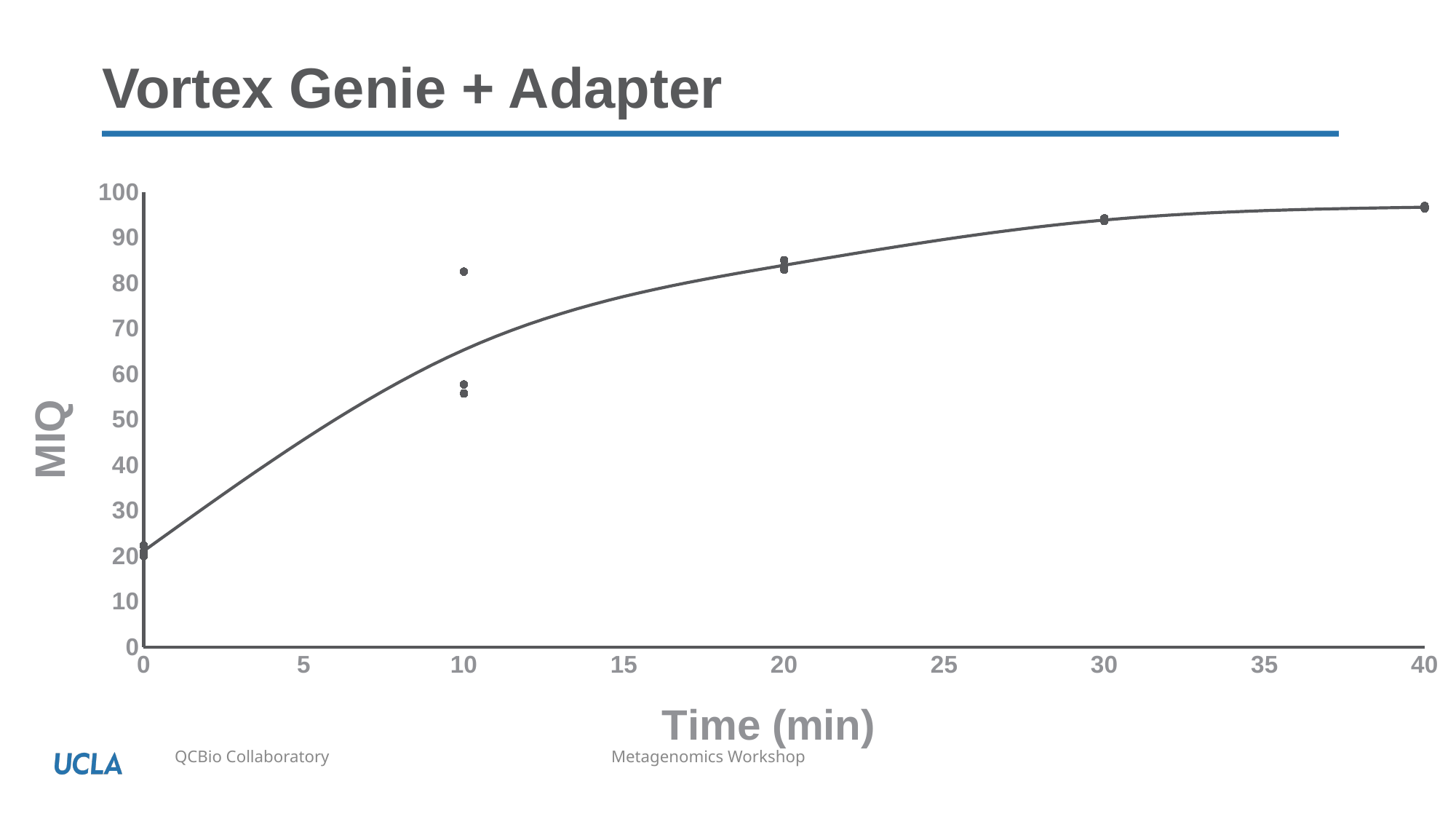
Is the MIQ value at 20 min greater or less than 80? greater Which has the higher MIQ, the point at 30 min or the point at 20 min? 30 min At which time point is MIQ highest? 40 min At which time point is MIQ lowest? 0 min How many distinct time points have data plotted? 5 What is the label of the y axis? MIQ Is the MIQ value at 40 min greater or less than 90? greater Does MIQ rise or fall as time increases along the x axis? Rises What kind of chart is shown on the slide? Scatter plot with a fitted curve What is the title of the chart? Vortex Genie + Adapter Is the MIQ value at 0 min greater or less than 30? less